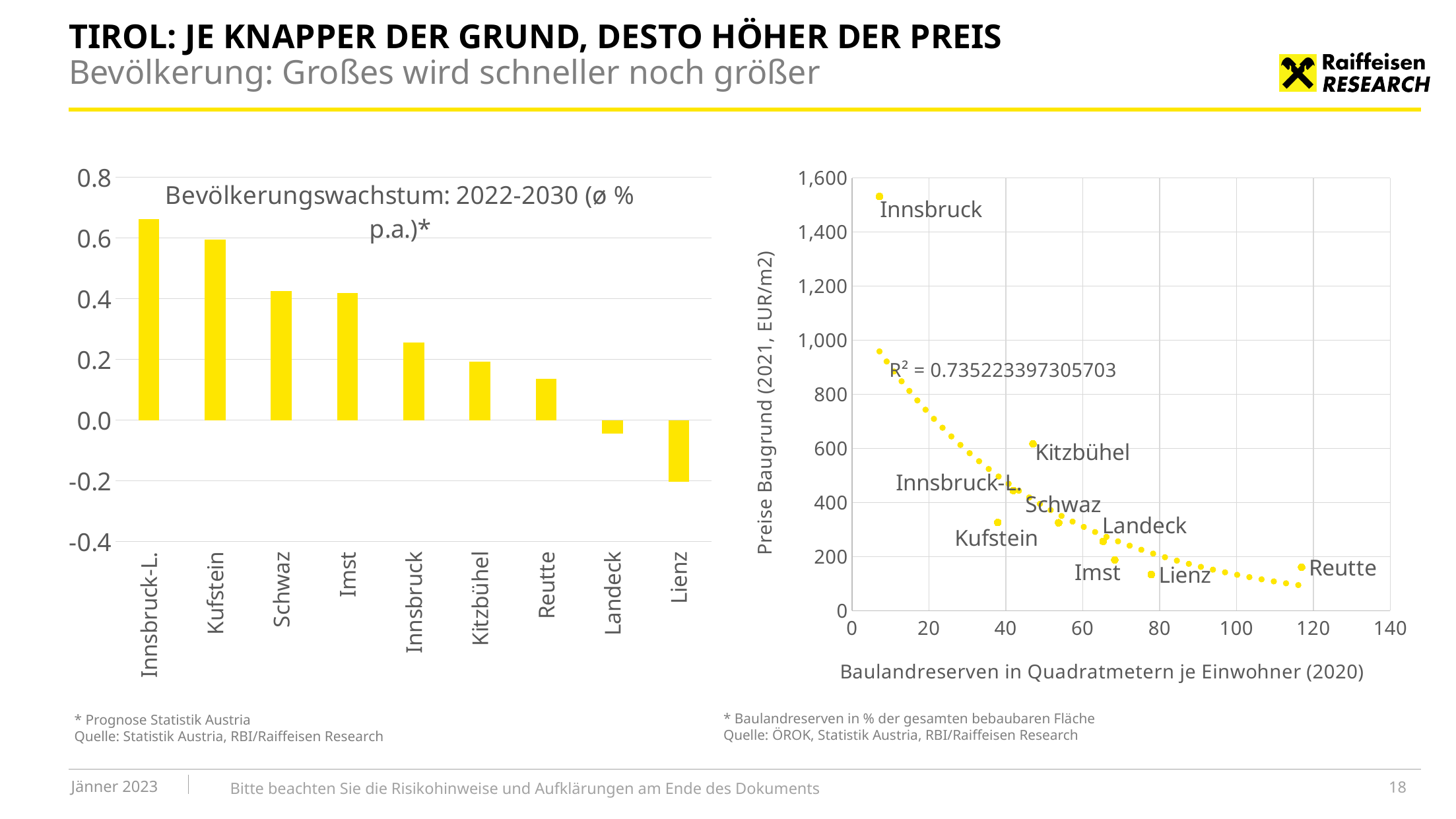
In the right scatter chart, which district has the highest Preise Baugrund? Innsbruck In the left bar chart 'Bevölkerungswachstum: 2022-2030', is the value for Innsbruck-L. greater or less than 0.6? greater In the left bar chart 'Bevölkerungswachstum: 2022-2030', how many districts have a negative value? 2 In the left bar chart 'Bevölkerungswachstum: 2022-2030', is the value for Lienz greater or less than 0.0? less What kind of chart is the right chart showing Preise Baugrund against Baulandreserven? scatter chart In the left bar chart 'Bevölkerungswachstum: 2022-2030', do the values rise or fall from left to right? fall How many districts are shown in the left bar chart 'Bevölkerungswachstum: 2022-2030'? 9 In the right scatter chart, what R² value is printed on the chart? R² = 0.735223397305703 In the left bar chart 'Bevölkerungswachstum: 2022-2030', which district has the lowest population growth? Lienz What kind of chart is the left chart, 'Bevölkerungswachstum: 2022-2030'? bar chart In the left bar chart 'Bevölkerungswachstum: 2022-2030', which district has the highest population growth? Innsbruck-L. In the left bar chart 'Bevölkerungswachstum: 2022-2030', which is larger, the value for Kufstein or the value for Schwaz? Kufstein